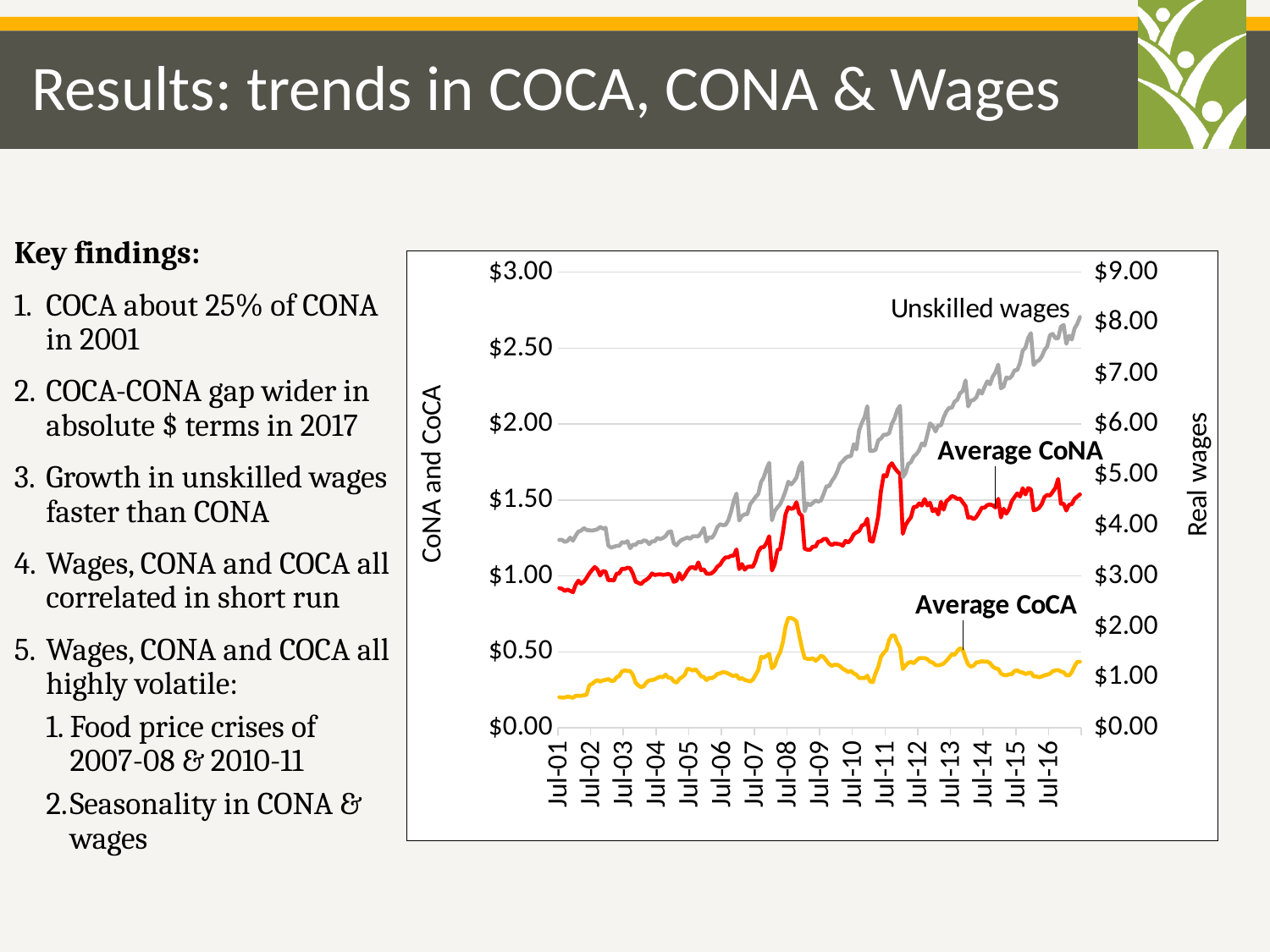
What is the title of the right vertical axis? Real wages What is the maximum value shown on the right vertical axis? $9.00 Which series is plotted lowest on the chart throughout the period? Average CoCA Which series is higher on the chart, Average CoNA or Average CoCA? Average CoNA Does the Unskilled wages series generally rise or fall from Jul-01 to Jul-16? rise Is the value of Average CoCA at Jul-01 greater or less than $0.50? less Is the peak value of Average CoCA around Jul-08 greater or less than $0.50? greater What kind of chart is shown on the slide? line chart Is the value of Average CoNA at Jul-01 greater or less than $1.00? less How many data series are plotted on the chart? 3 How many year labels are shown on the x axis? 16 What is the title of the left vertical axis? CoNA and CoCA